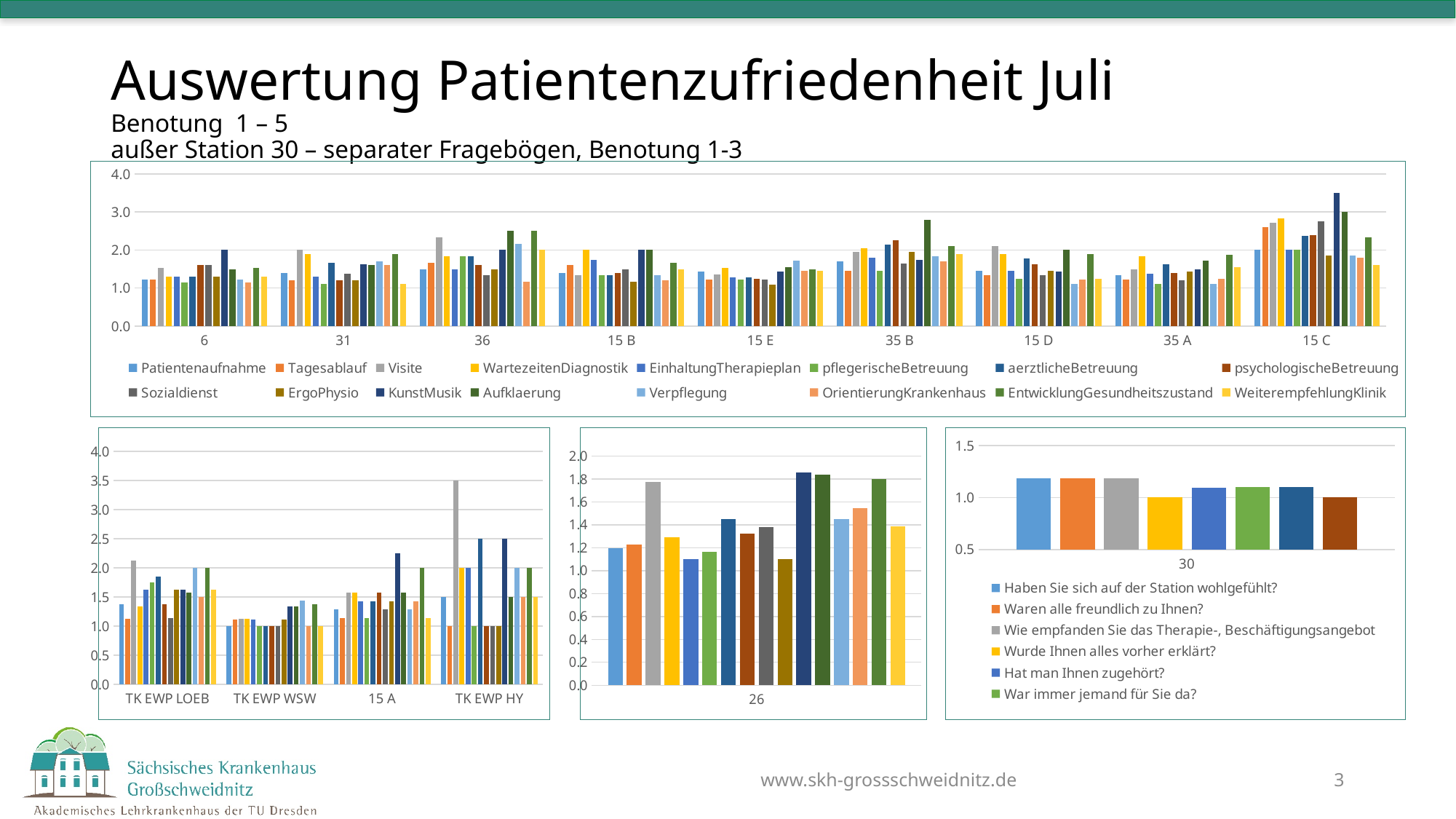
In the top chart, how many series does the legend list? 16 In the top chart, is the value of KunstMusik for station 15 C greater or less than 3.0? greater In the bottom-right chart for station 30, how many questions does the legend list? 6 In the bottom-left chart, which category contains the tallest bar? TK EWP HY In the top chart, is the value of Patientenaufnahme for station 6 greater or less than 2.0? less In the top chart, how many station categories are shown on the x axis? 9 In the bottom-left chart, how many categories are shown on the x axis? 4 In the bottom-left chart, is the tallest bar for TK EWP HY greater or less than 3.0? greater In the top chart, which station category contains the tallest bar? 15 C What kind of chart is the large chart at the top of the slide? bar chart